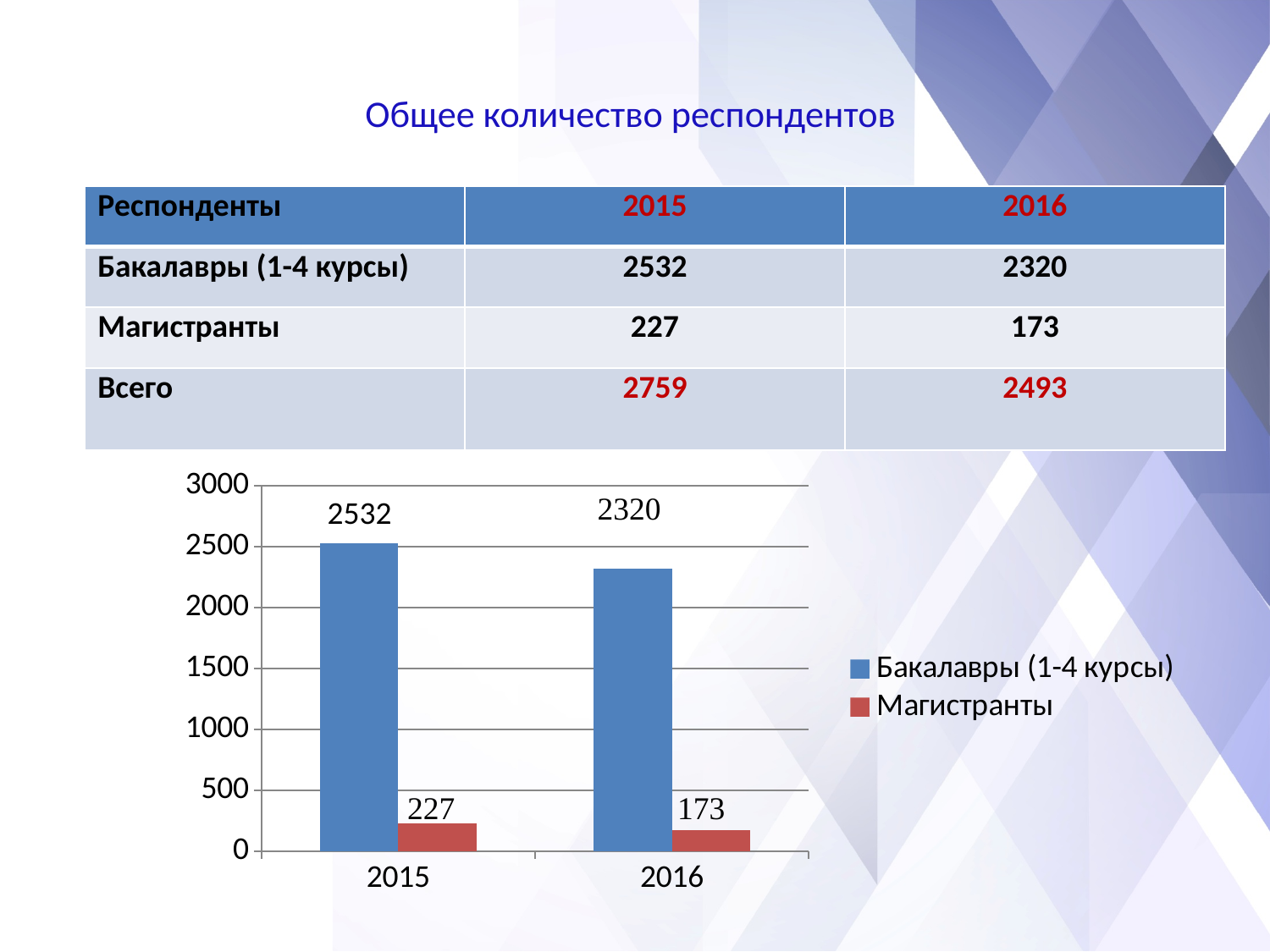
What is the value for Магистранты in 2015? 227 Do the values for Магистранты rise or fall from 2015 to 2016? fall Is the value for Бакалавры (1-4 курсы) in 2016 greater or less than 2500? less What is the value for Бакалавры (1-4 курсы) in 2015? 2532 What is the value for Магистранты in 2016? 173 Which year has the higher value for Бакалавры (1-4 курсы)? 2015 Which year has the lower value for Магистранты? 2016 What kind of chart is shown on the slide? bar chart How many series does the legend list? 2 What is the difference between the Бакалавры (1-4 курсы) values for 2015 and 2016? 212 What is the value for Бакалавры (1-4 курсы) in 2016? 2320 What is the difference between the Магистранты values for 2015 and 2016? 54